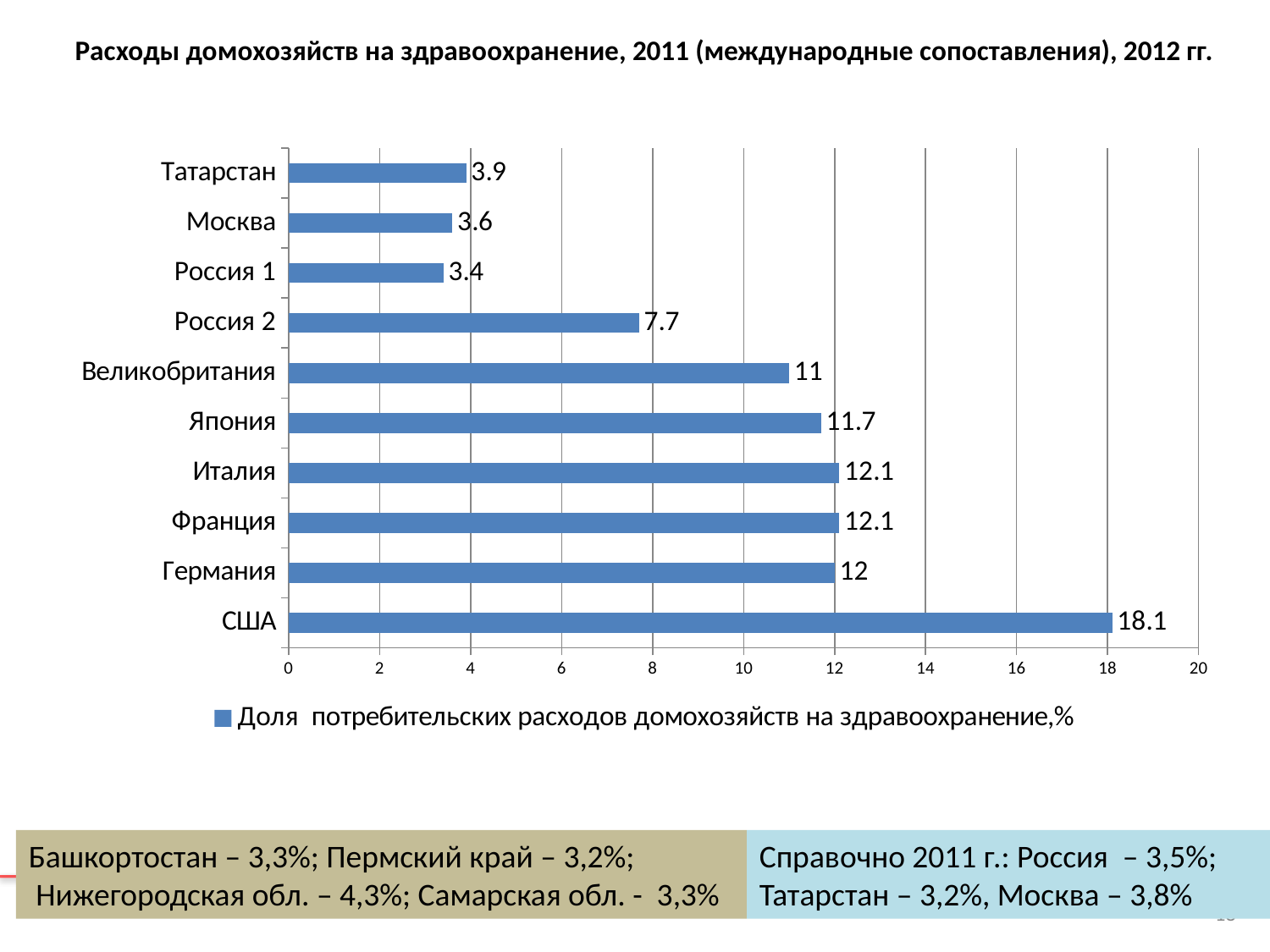
Is the value for Италия greater or less than 10? greater What is the difference between the values for США and Германия? 6.1 What is the value for США? 18.1 Which category has the lowest value? Россия 1 What is the value for Россия 2? 7.7 What kind of chart is shown on the slide? bar chart How many categories are shown in the chart? 10 How many series does the legend list? 1 What is the value for Япония? 11.7 Which is larger, the value for Великобритания or the value for Россия 2? Великобритания What is the difference between the values for Татарстан and Москва? 0.3 Which category has the highest value? США